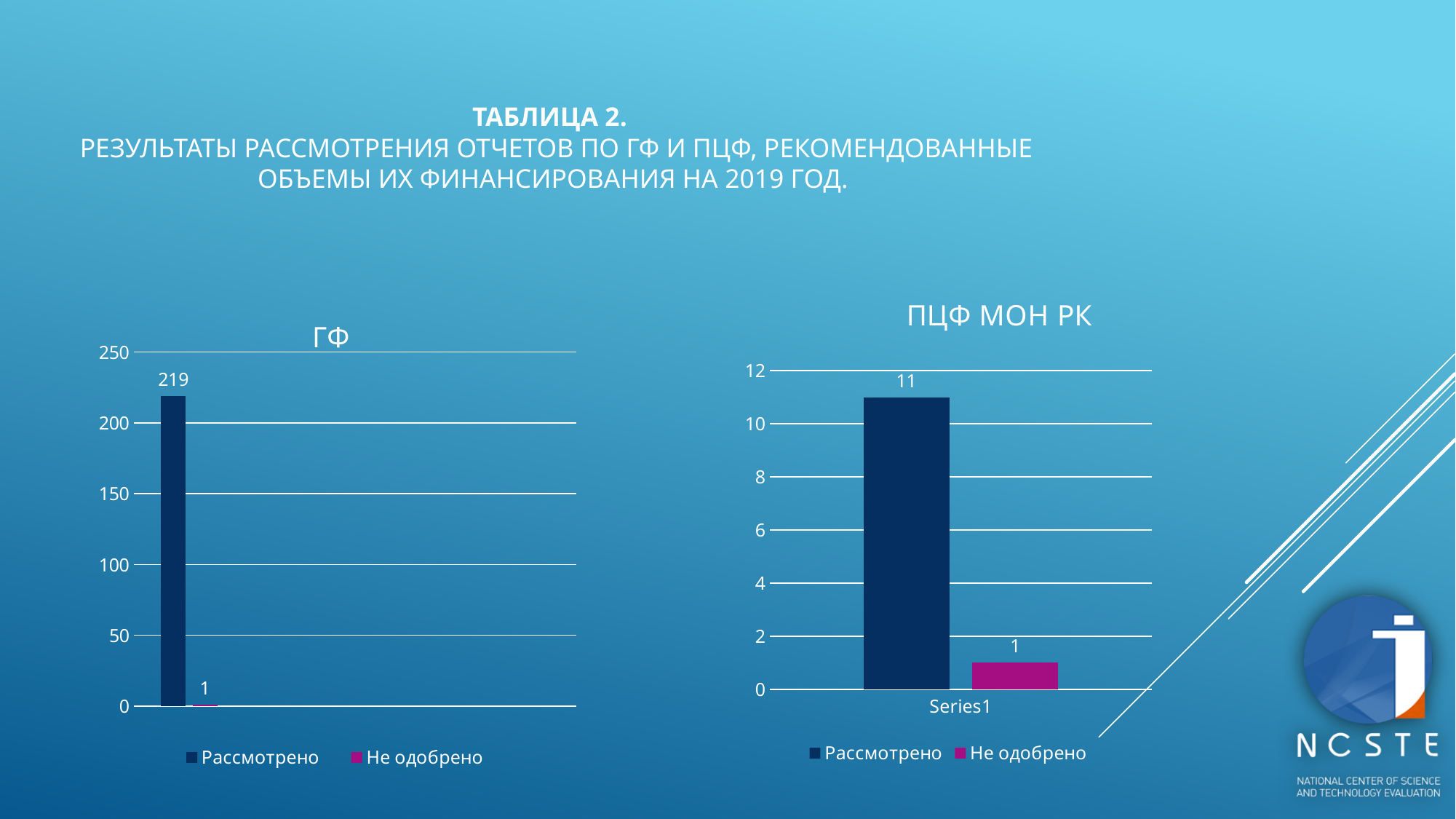
What is the title of the chart on the right side of the slide? ПЦФ МОН РК In the ПЦФ МОН РК chart, what is the difference between Рассмотрено and Не одобрено? 10 In the ГФ chart, is the value for Рассмотрено greater or less than 200? greater In the ПЦФ МОН РК chart, what is the value for Не одобрено? 1 In the ГФ chart, what is the value for Рассмотрено? 219 In the ПЦФ МОН РК chart, what is the value for Рассмотрено? 11 In the ПЦФ МОН РК chart, what colour is the Не одобрено bar? magenta In the ПЦФ МОН РК chart, which series has the higher value, Рассмотрено or Не одобрено? Рассмотрено How many series does the legend of the ГФ chart list? 2 What kind of chart is the ПЦФ МОН РК chart? bar chart In the ГФ chart, what is the difference between Рассмотрено and Не одобрено? 218 In the ГФ chart, what is the value for Не одобрено? 1